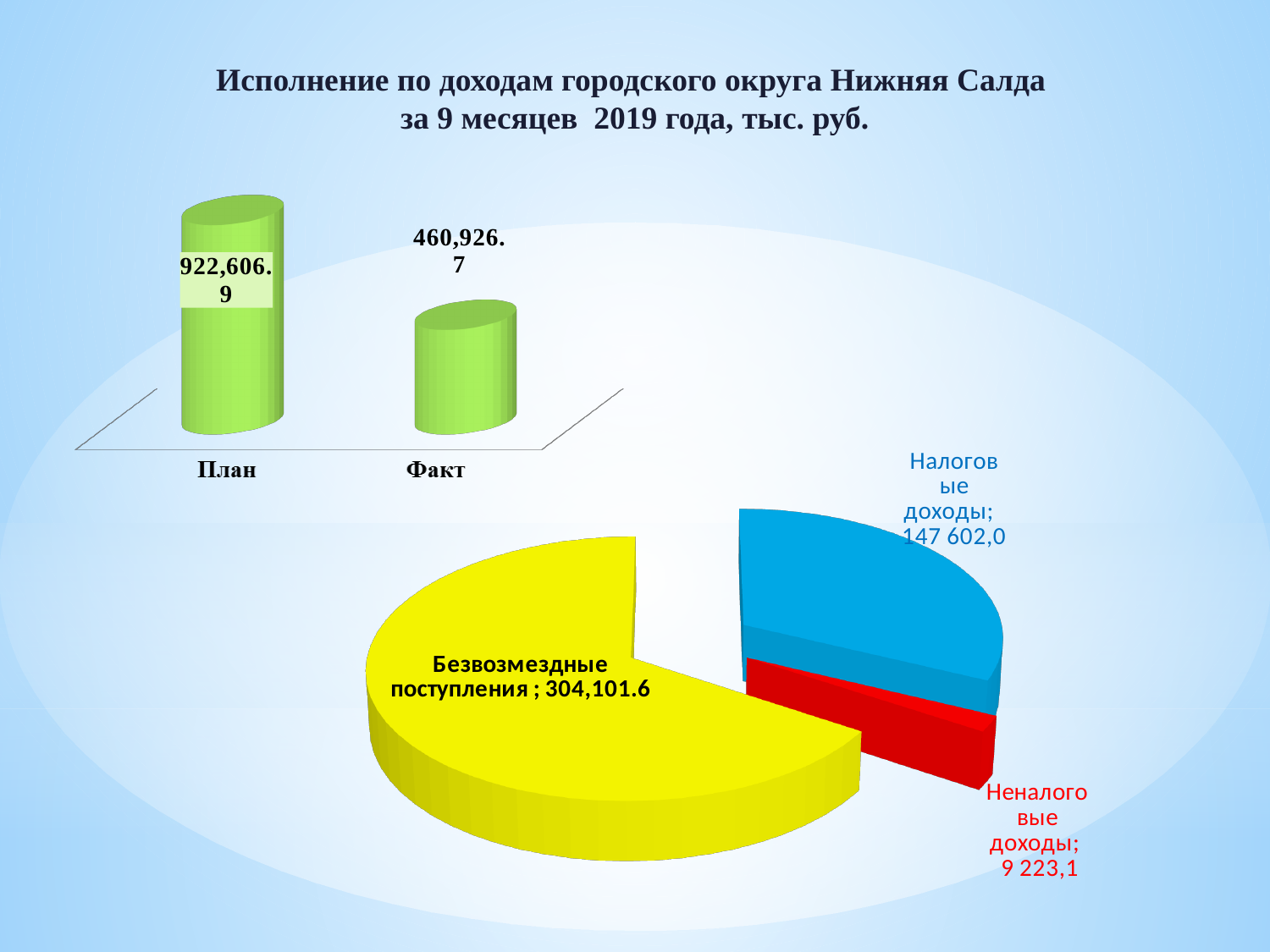
On the bar chart at the top left, how many categories are shown? 2 On the bar chart at the top left, what is the value for Факт? 460,926.7 On the bar chart at the top left, what is the value for План? 922,606.9 On the bar chart at the top left, what is the difference between План and Факт? 461,680.2 On the pie chart, what is the value for Неналоговые доходы? 9 223,1 What type of chart is shown at the top left of the slide? Bar chart On the pie chart, what is the value for Безвозмездные поступления? 304,101.6 On the pie chart, which slice is the smallest? Неналоговые доходы On the bar chart at the top left, which category has the higher value, План or Факт? План On the pie chart, which slice is the largest? Безвозмездные поступления On the pie chart, what is the value for Налоговые доходы? 147 602,0 On the pie chart, how many slices are there? 3